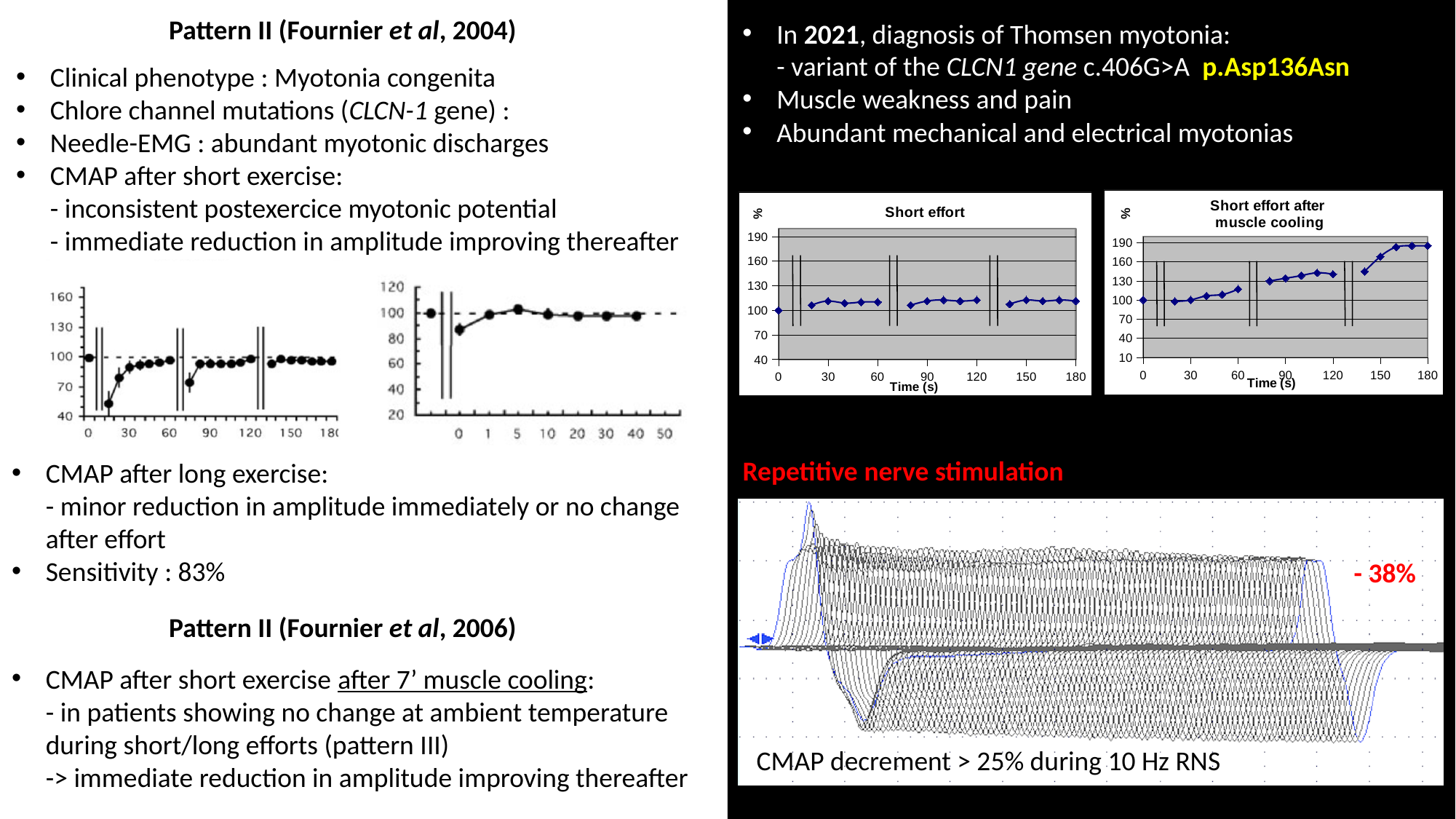
What is the x-axis label of the "Short effort" chart? Time (s) In the "Short effort" chart, is the value at 90 s greater or less than 160? less In the "Short effort after muscle cooling" chart, at which time is the value highest? 170 s and 180 s (tied) What is the title of the rightmost line chart on the slide? Short effort after muscle cooling In the "Short effort" chart, is the value at 180 s greater or less than 130? less In the "Short effort after muscle cooling" chart, do the values rise or fall as time increases from 0 to 180 s? rise What type of chart is the "Short effort" chart on the right side of the slide? line chart In the "Short effort after muscle cooling" chart, which is larger: the value at 180 s or the value at 30 s? the value at 180 s In the "Short effort" chart, what is the value at time 0 s? 100 In the "Short effort after muscle cooling" chart, what is the value at time 0 s? 100 In the "Short effort after muscle cooling" chart, is the value at 30 s greater or less than 130? less